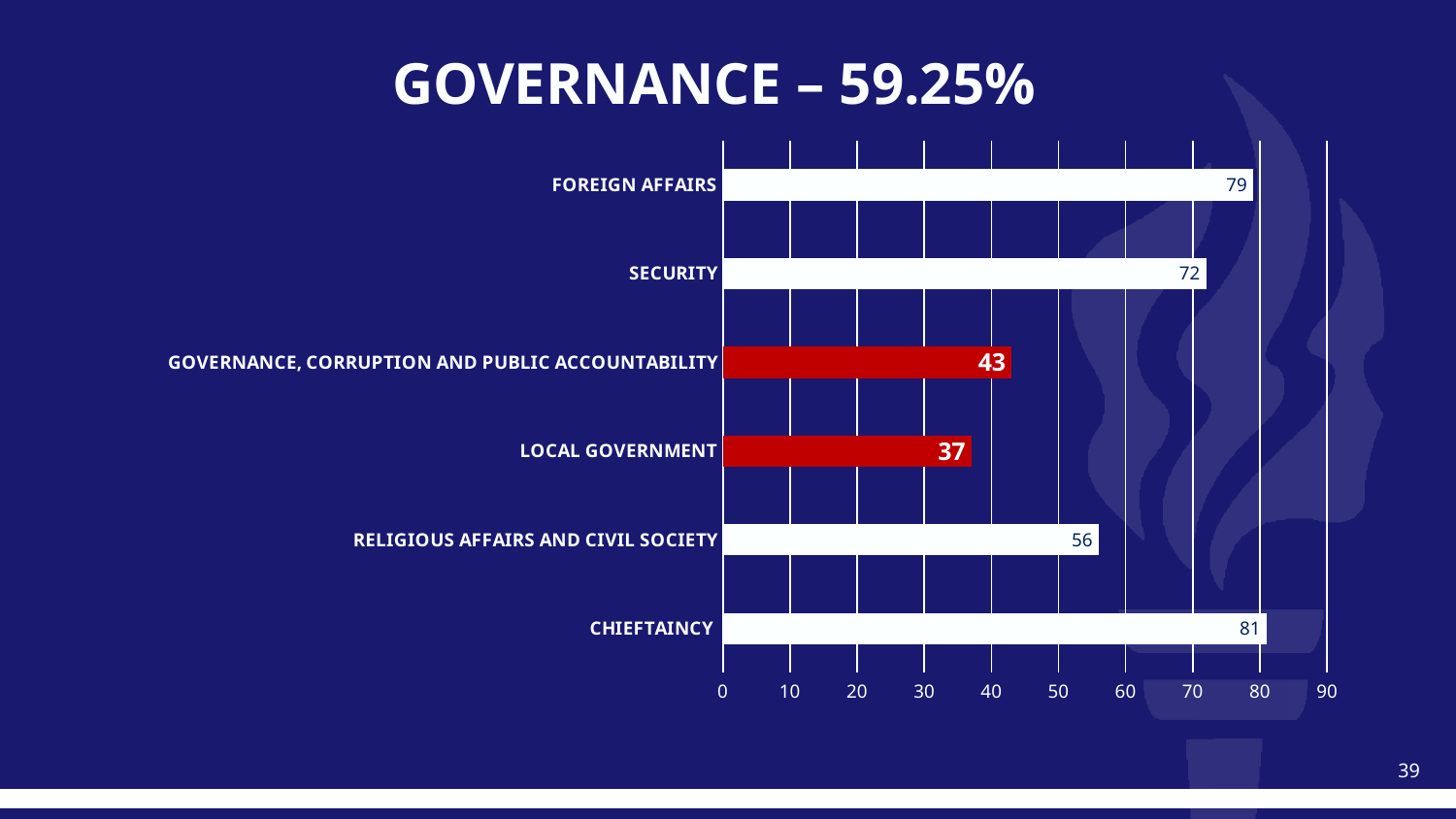
What is the difference between the values for Chieftaincy and Security? 9 Is the value for Governance, Corruption and Public Accountability greater or less than 50? less Which is larger, the value for Security or the value for Religious Affairs and Civil Society? Security How many categories are shown in the chart? 6 Which category has the lowest value? Local Government What is the value for Religious Affairs and Civil Society? 56 What kind of chart is shown on the slide? bar chart What is the difference between the values for Governance, Corruption and Public Accountability and Local Government? 6 What is the title of the slide? GOVERNANCE – 59.25% What is the value for Foreign Affairs? 79 Which category has the highest value? Chieftaincy What is the value for Local Government? 37